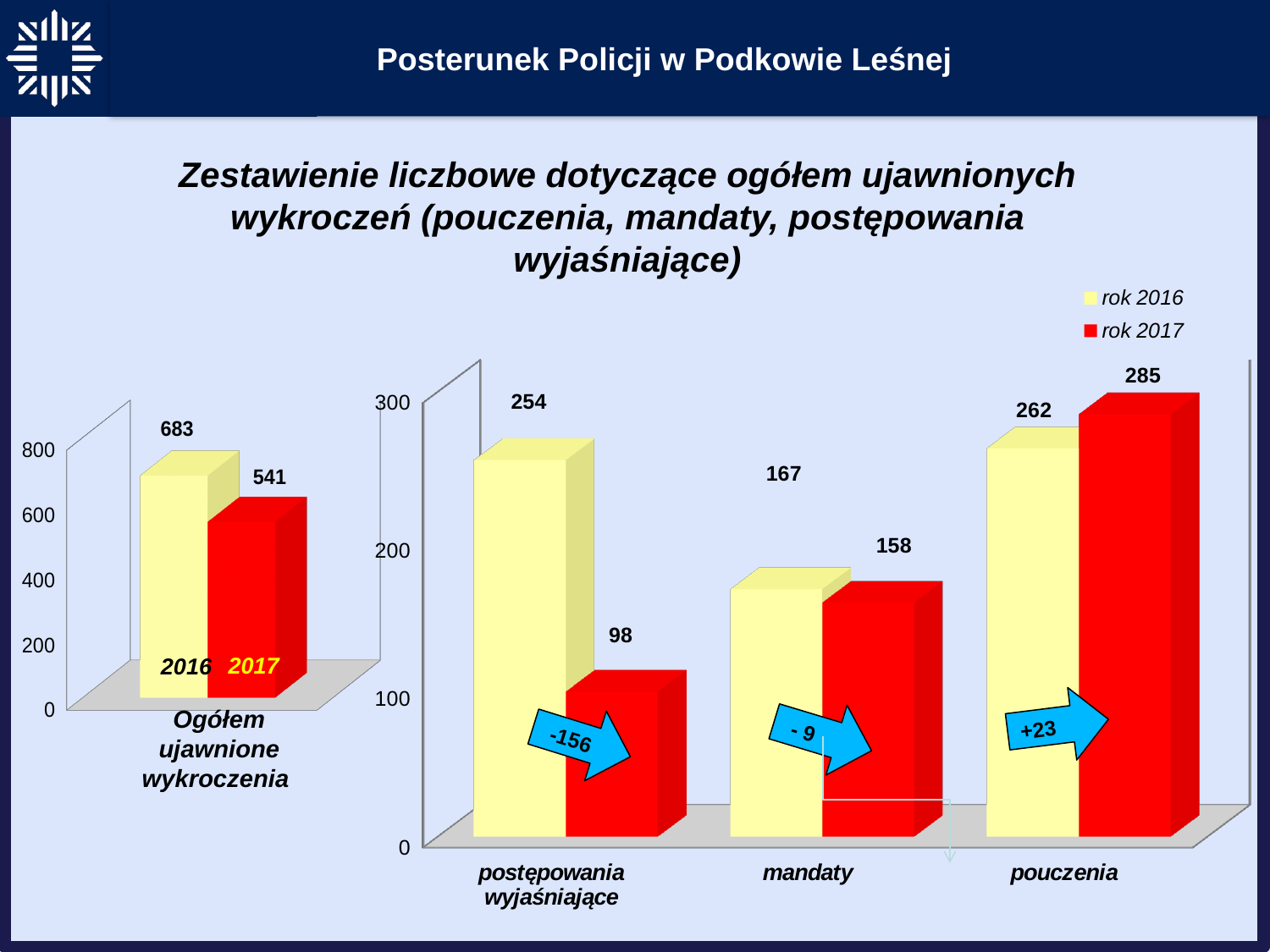
In the right chart, which category has the highest rok 2017 value? pouczenia In the right chart, which is larger for pouczenia: the rok 2016 value or the rok 2017 value? rok 2017 In the right chart, what is the rok 2017 value for mandaty? 158 What kind of chart is the right chart? bar chart In the left chart (Ogółem ujawnione wykroczenia), what is the value for 2016? 683 In the right chart, what is the difference between the rok 2016 and rok 2017 values for postępowania wyjaśniające? 156 In the right chart, which category has the lowest rok 2017 value? postępowania wyjaśniające In the right chart, what is the rok 2017 value for pouczenia? 285 How many series does the legend of the right chart list? 2 In the left chart (Ogółem ujawnione wykroczenia), what is the difference between the 2016 and 2017 values? 142 In the left chart (Ogółem ujawnione wykroczenia), what is the value for 2017? 541 In the right chart, what is the rok 2016 value for postępowania wyjaśniające? 254